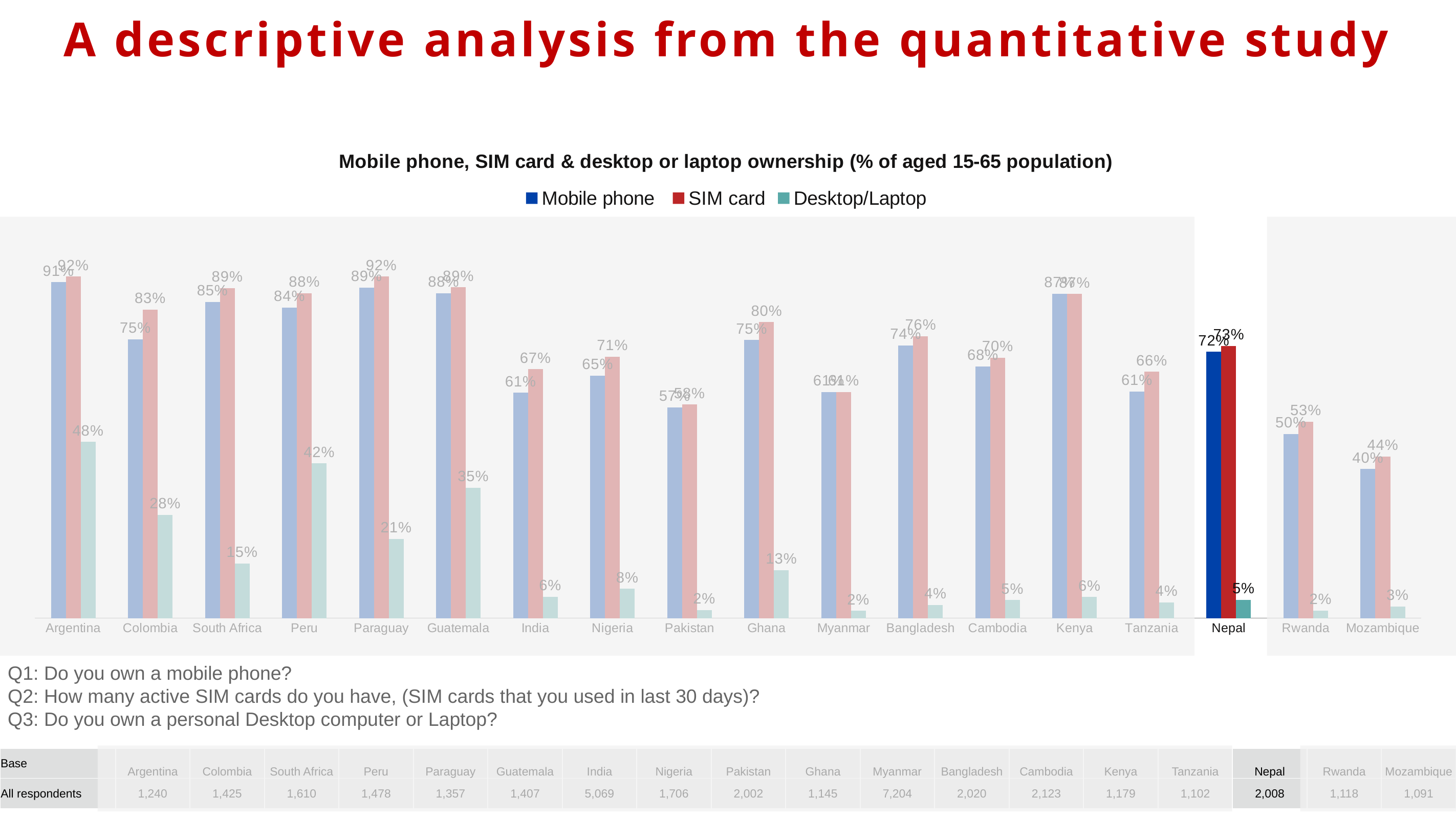
What is the Desktop/Laptop value for Nepal? 5% What is the difference between the Desktop/Laptop values for Peru and Colombia? 14 percentage points What kind of chart is shown on the slide? Bar chart What is the SIM card value for Ghana? 80% Which country has the larger Desktop/Laptop value, Guatemala or Peru? Peru What is the Desktop/Laptop ownership value for Argentina? 48% Which country has the lowest Mobile phone ownership? Mozambique Which country has the highest Desktop/Laptop ownership? Argentina What is the Mobile phone value for Colombia? 75% Which country's bars are highlighted in darker colours than the rest of the chart? Nepal How many series does the chart legend list? 3 How many countries are shown on the x axis of the chart? 18